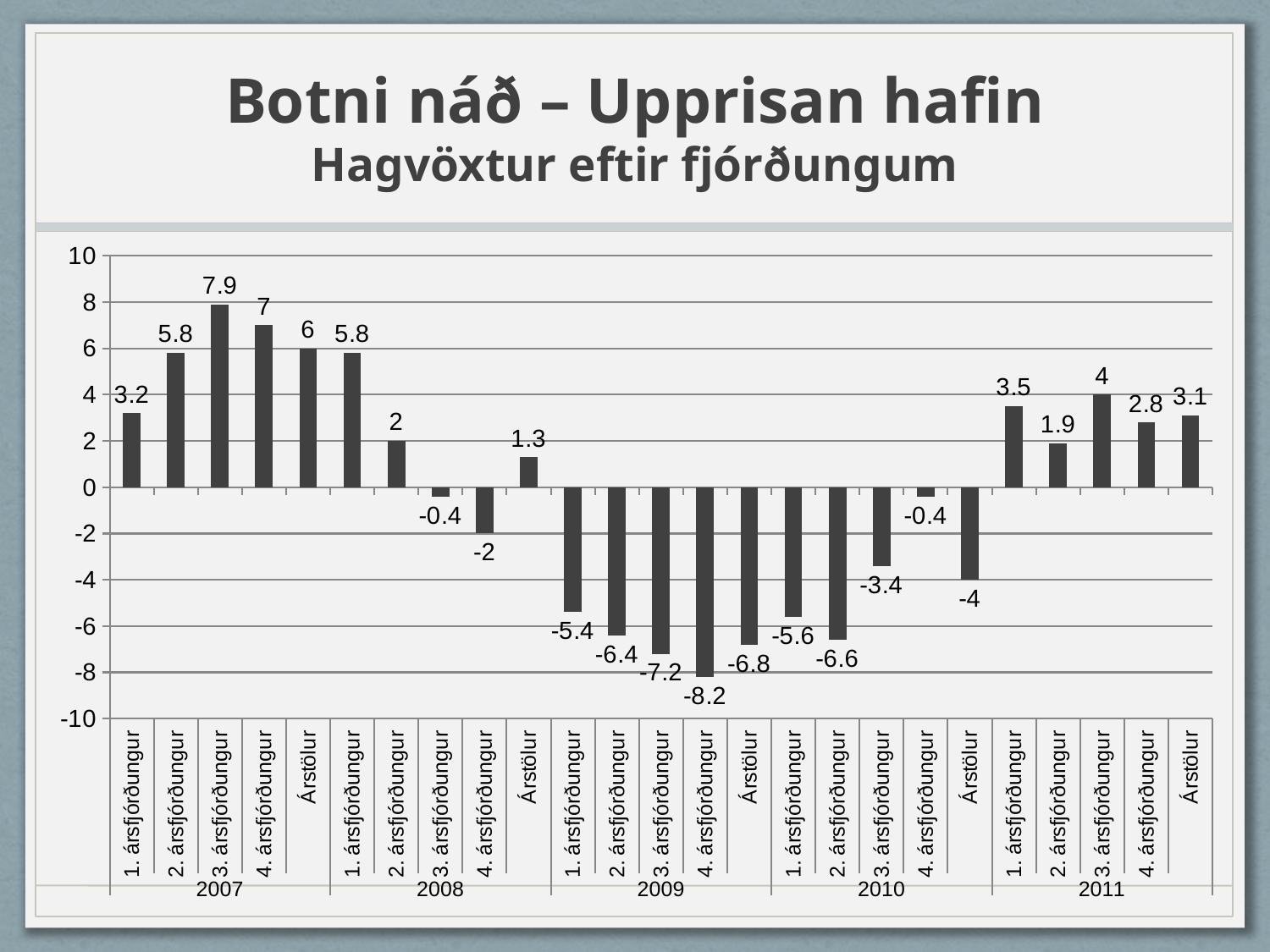
What is the subtitle of the chart on the slide? Hagvöxtur eftir fjórðungum What kind of chart is shown on the slide? Bar chart What is the value for 4. ársfjórðungur 2010? -0.4 What is the Árstölur value for 2011? 3.1 Which is larger, the value for 1. ársfjórðungur 2011 or the value for 3. ársfjórðungur 2011? 3. ársfjórðungur 2011 What is the value for 3. ársfjórðungur 2007? 7.9 Do the values rise or fall across the four quarters of 2009? Fall What is the Árstölur value for 2009? -6.8 Which bar has the lowest value on the chart? 4. ársfjórðungur 2009 Which bar has the highest value on the chart? 3. ársfjórðungur 2007 What is the difference between the Árstölur value for 2007 and the Árstölur value for 2010? 10 How many bars are plotted on the chart? 25